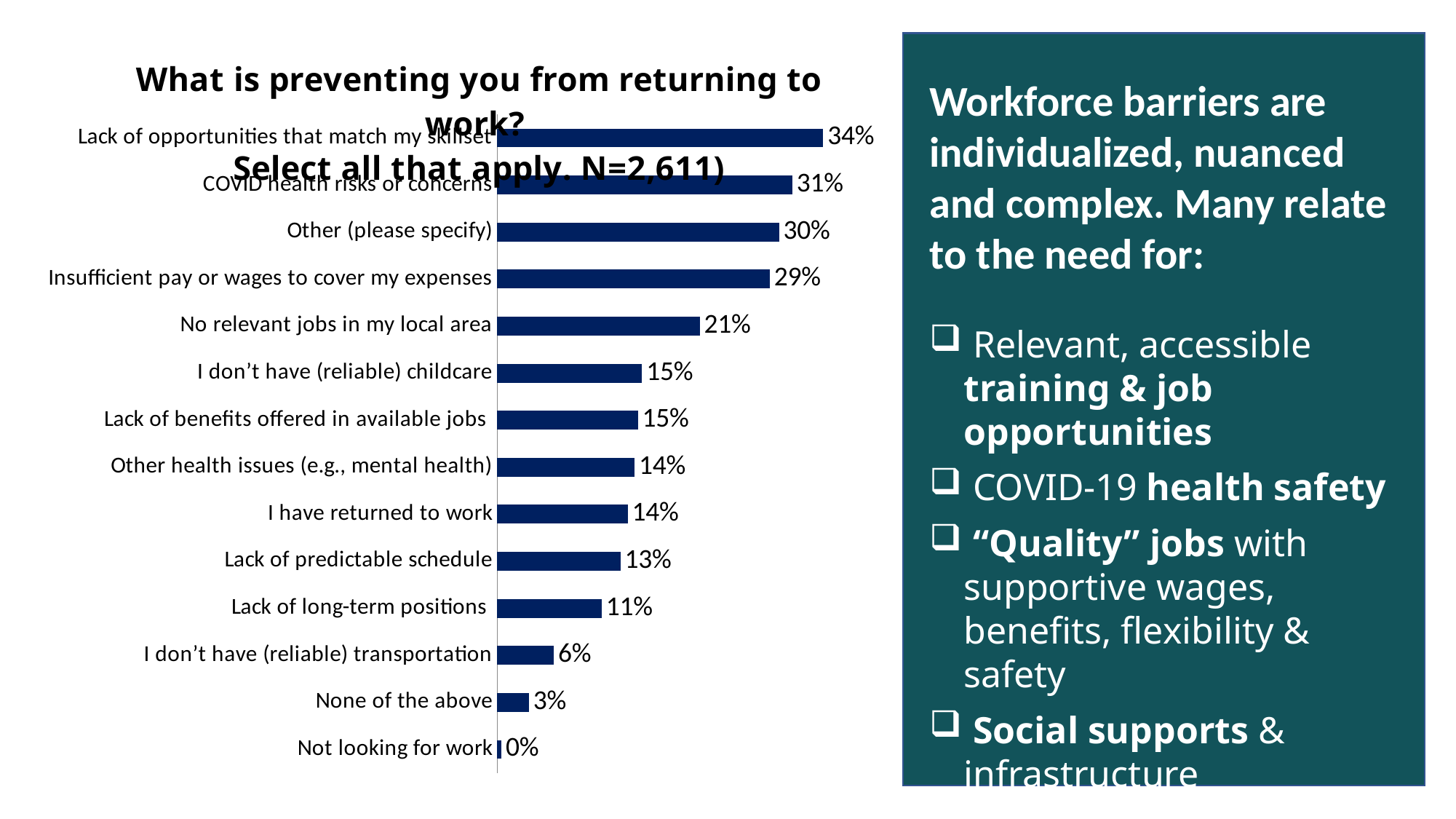
What percentage of respondents selected "None of the above"? 3% Which is larger: the value for "Other (please specify)" or the value for "No relevant jobs in my local area"? Other (please specify) Which barrier has the highest percentage in the chart? Lack of opportunities that match my skillset What percentage is shown for "I don't have (reliable) transportation"? 6% What percentage of respondents selected "Insufficient pay or wages to cover my expenses"? 29% How many categories (bars) are shown in the chart? 14 What type of chart is shown on the slide? Bar chart Which category has the lowest value in the chart? Not looking for work What value is shown for "Lack of predictable schedule"? 13% What is the value shown for "No relevant jobs in my local area"? 21% What is the difference in percentage points between "COVID health risks or concerns" and "Lack of long-term positions"? 20 What is the sample size (N) stated in the chart title? 2,611